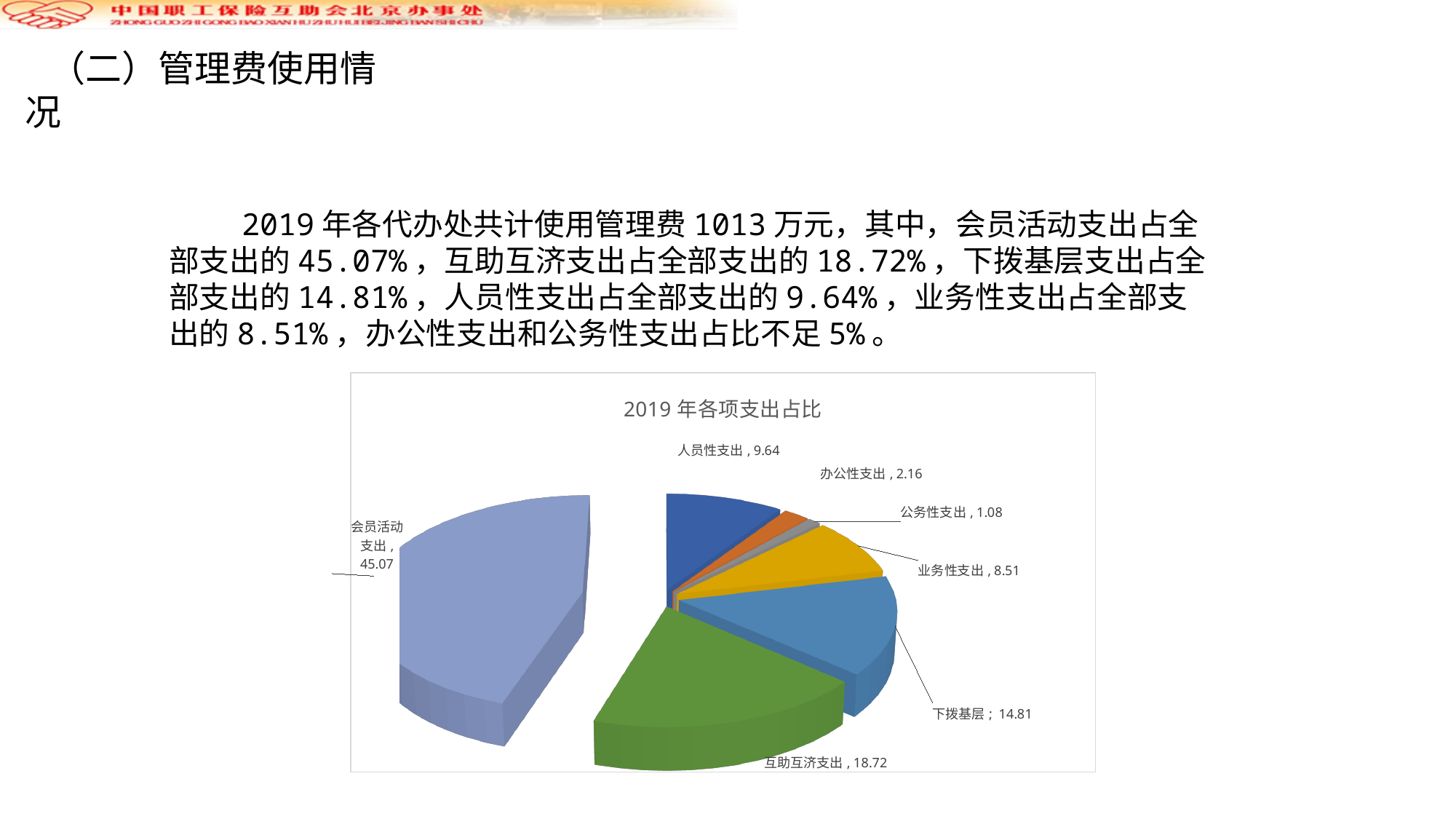
Which is larger in the pie chart, 人员性支出 or 业务性支出? 人员性支出 How many slices does the pie chart have? 7 What is the value shown for 会员活动支出 in the pie chart? 45.07 What is the value shown for 下拨基层 in the pie chart? 14.81 Which category has the smallest slice in the pie chart? 公务性支出 What is the difference between the values for 办公性支出 and 公务性支出 in the pie chart? 1.08 What is the value shown for 公务性支出 in the pie chart? 1.08 What is the value shown for 互助互济支出 in the pie chart? 18.72 Which category has the largest slice in the pie chart? 会员活动支出 What is the difference between the values for 互助互济支出 and 下拨基层 in the pie chart? 3.91 What type of chart is shown on the slide? pie chart What is the title of the pie chart? 2019年各项支出占比